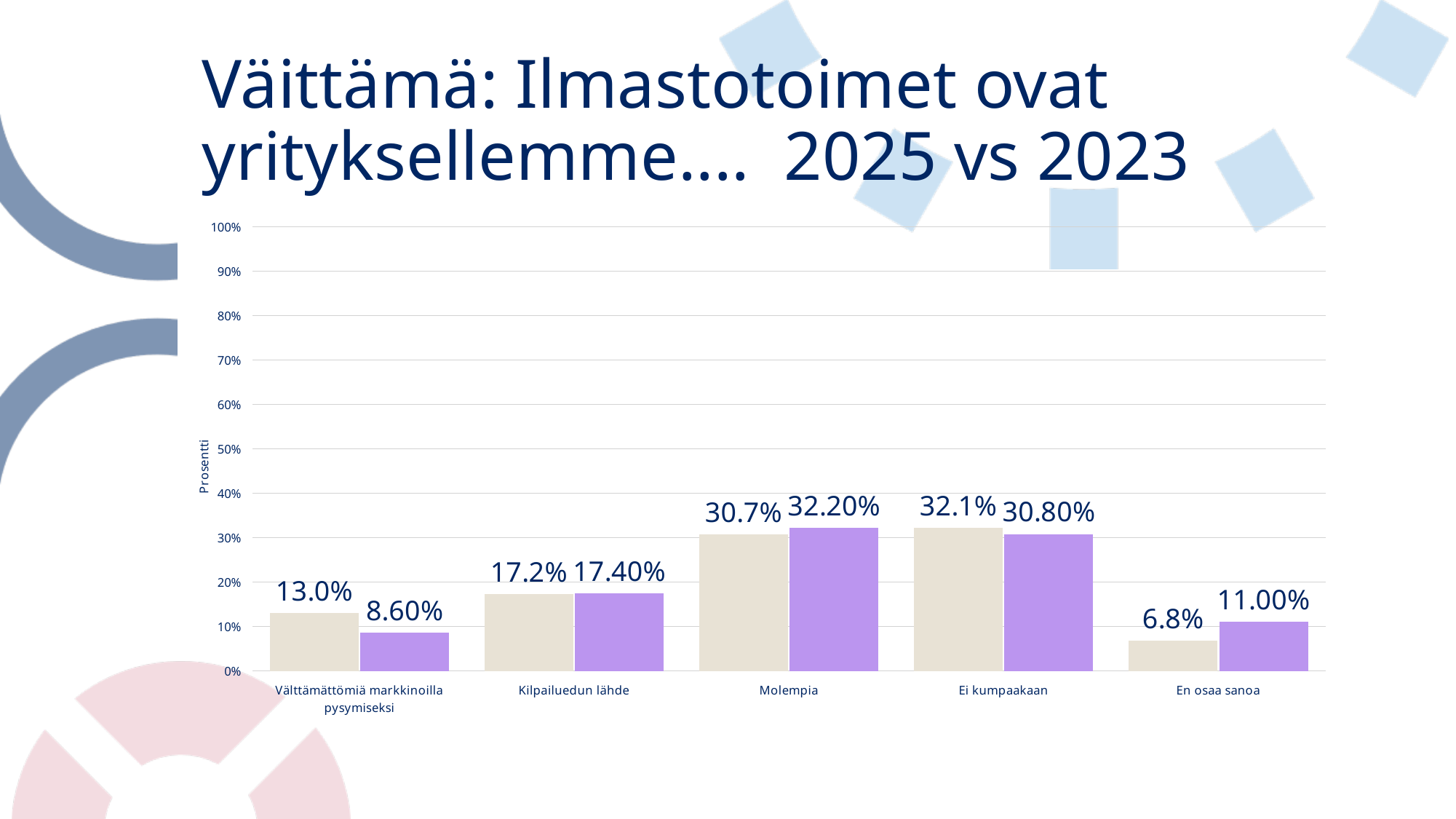
What is the value of the purple (right) bar for "En osaa sanoa"? 11.00% What is the value of the beige (left) bar for "Molempia"? 30.7% Which category has the highest beige (left) bar? Ei kumpaakaan Is the value of the beige (left) bar for "Kilpailuedun lähde" greater or less than 20%? less What is the label of the vertical axis? Prosentti Which category has the lowest purple (right) bar? Välttämättömiä markkinoilla pysymiseksi What is the value of the purple (right) bar for "Välttämättömiä markkinoilla pysymiseksi"? 8.60% How many categories are shown on the x axis? 5 For "En osaa sanoa", which bar is larger, the beige (left) or the purple (right)? purple (right) What kind of chart is shown on the slide? bar chart Which category has the lowest beige (left) bar? En osaa sanoa What is the difference between the beige and purple bars for "Välttämättömiä markkinoilla pysymiseksi"? 4.4%